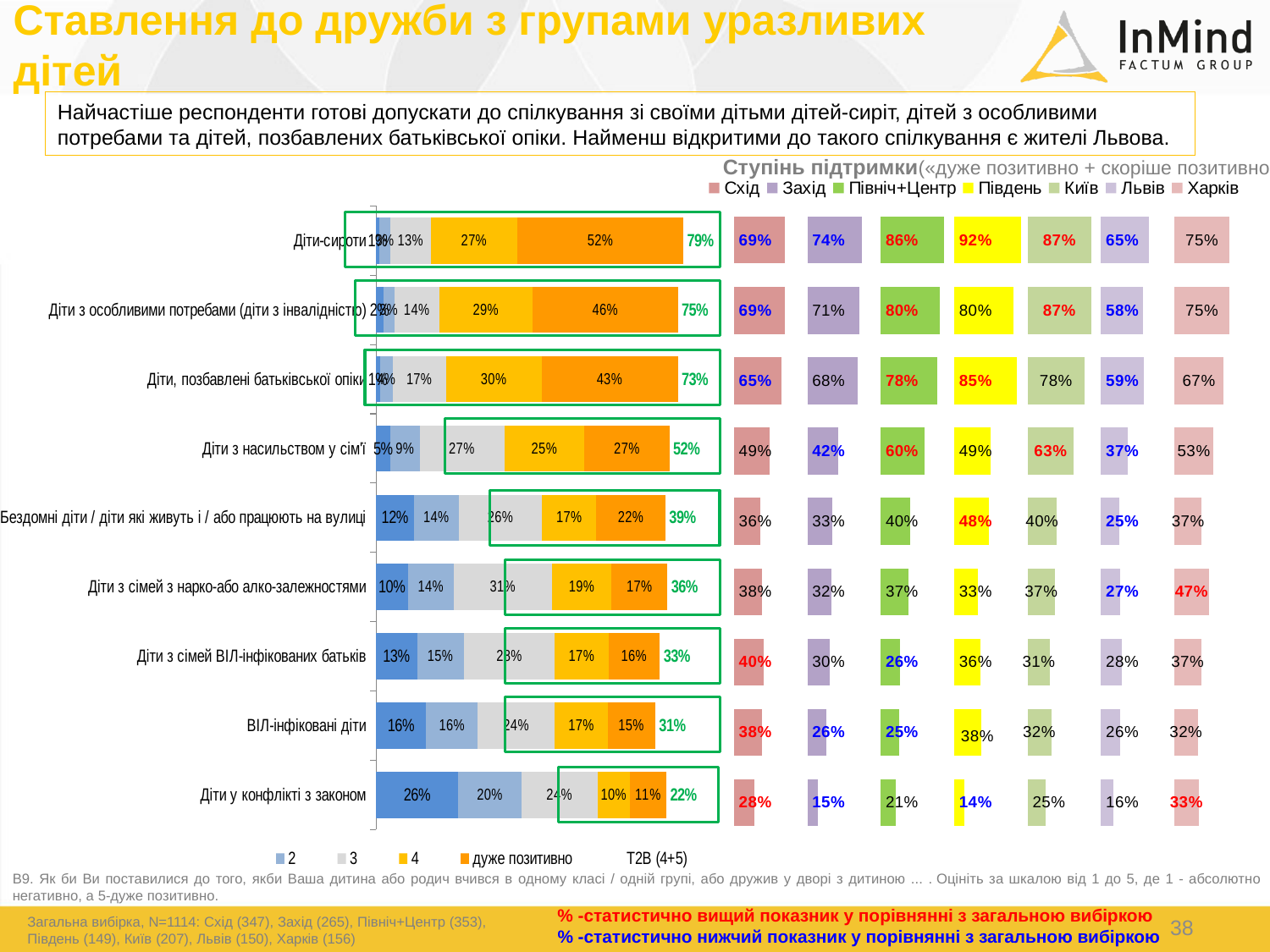
What is the difference between the T2B (4+5) values for Діти-сироти and Діти у конфлікті з законом? 57 percentage points How many categories of children are shown in the bar chart? 9 How many entries does the legend below the bar chart list? 5 Do the T2B (4+5) values rise or fall going from the top category to the bottom category? Fall What share of respondents answered «дуже позитивно» for Діти-сироти? 52% Which category has the lowest T2B (4+5) value? Діти у конфлікті з законом What is the T2B (4+5) value for Діти-сироти? 79% Which category has the highest T2B (4+5) value? Діти-сироти Which has a larger «дуже позитивно» share: Діти з насильством у сім'ї or Бездомні діти / діти які живуть і / або працюють на вулиці? Діти з насильством у сім'ї What is the value of segment «2» for Діти у конфлікті з законом? 20% What type of chart is used to show attitudes toward the groups of children? Stacked bar chart What is the value of segment «4» for Діти, позбавлені батьківської опіки? 30%